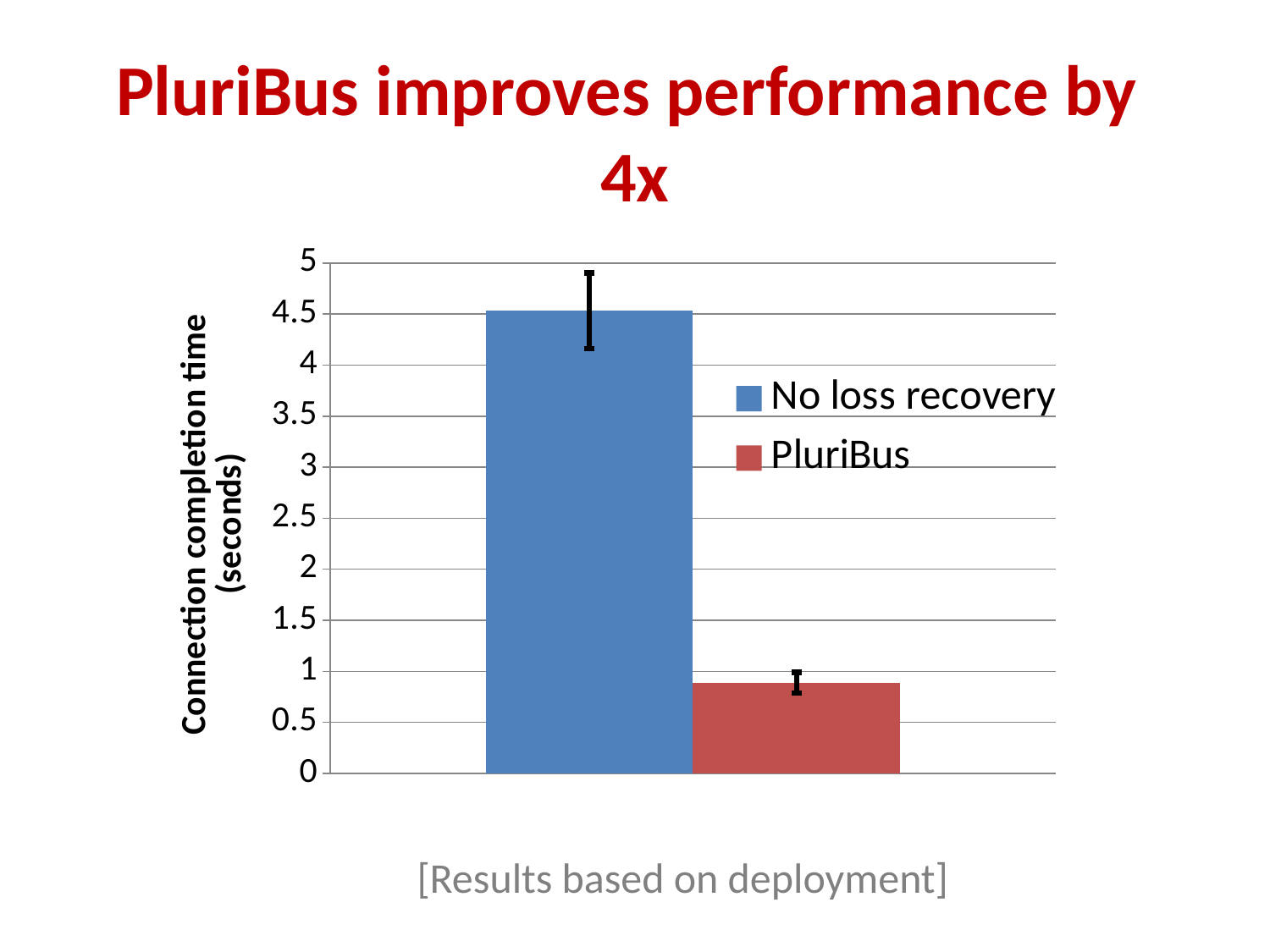
Which is larger, the connection completion time for No loss recovery or for PluriBus? No loss recovery What kind of chart is shown on the slide? bar chart Is the connection completion time for No loss recovery greater or less than 5 seconds? less Which colour represents the PluriBus series in the legend? red What is the label of the vertical axis? Connection completion time (seconds) Which series has the lowest connection completion time? PluriBus How many series does the legend list? 2 Which series has the highest connection completion time? No loss recovery Is the connection completion time for No loss recovery greater or less than 4 seconds? greater How many bars are plotted in the chart? 2 Is the connection completion time for PluriBus greater or less than 0.5 seconds? greater